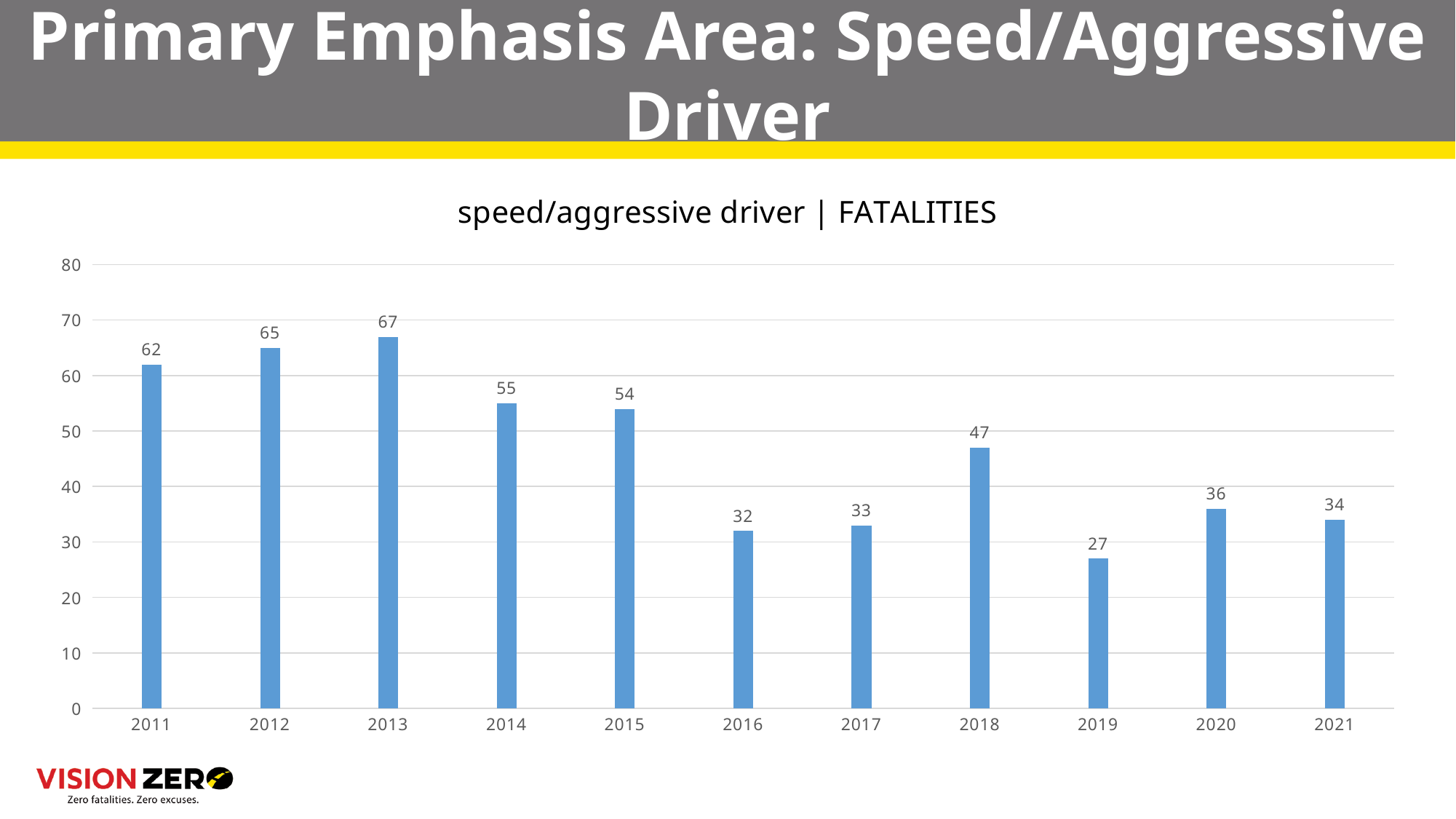
What is the difference in fatalities between 2018 and 2019? 20 What is the difference in fatalities between 2011 and 2016? 30 Is the value for 2018 greater or less than 40? greater What is the number of speed/aggressive driver fatalities in 2013? 67 What is the number of speed/aggressive driver fatalities in 2021? 34 Which year has the highest number of fatalities? 2013 How many years are shown on the x axis? 11 What is the number of speed/aggressive driver fatalities in 2019? 27 Which year had more fatalities, 2014 or 2020? 2014 Which year has the lowest number of fatalities? 2019 What kind of chart is shown on the slide? Bar chart What is the title of the chart? speed/aggressive driver | FATALITIES